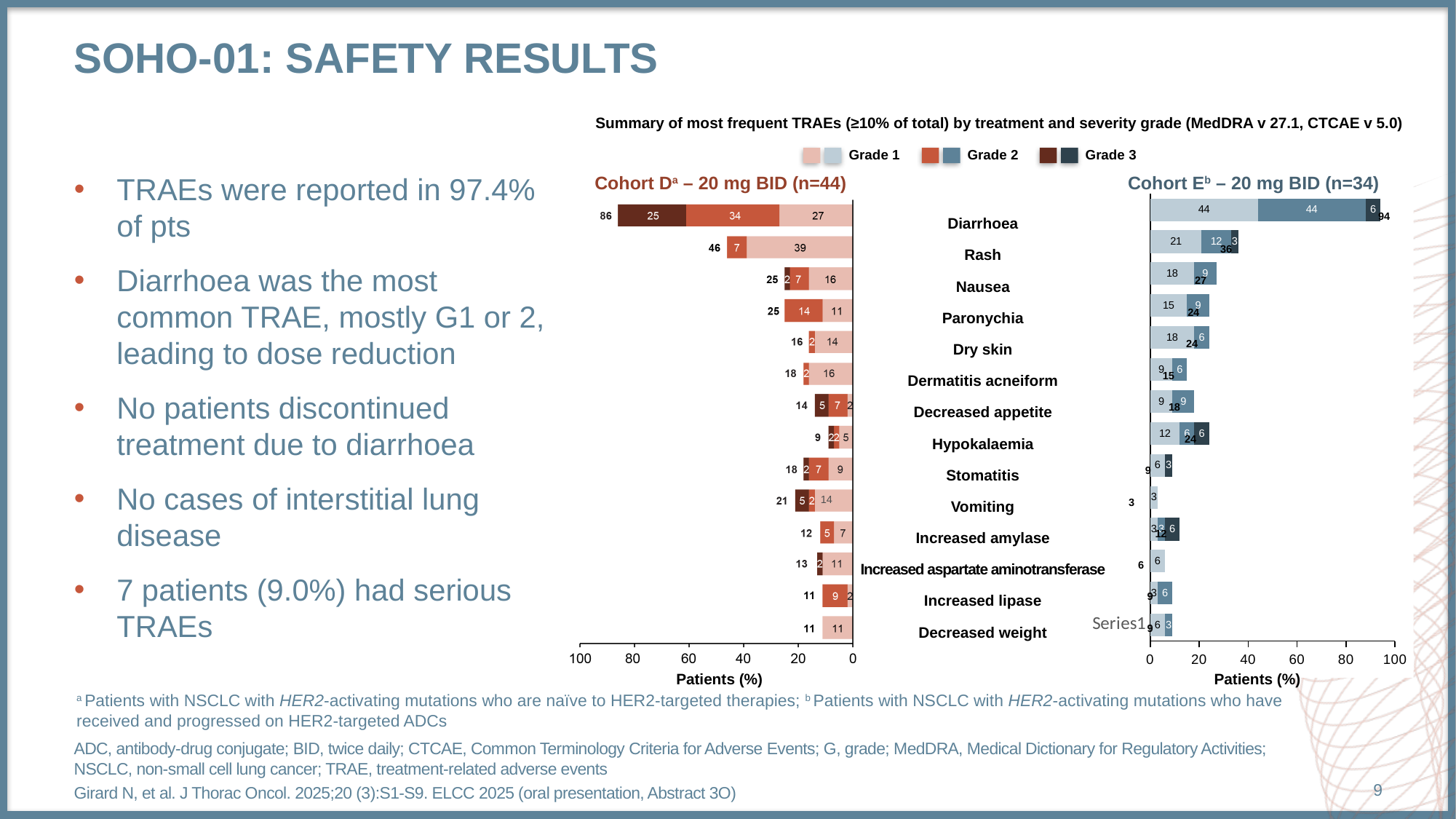
How many TRAE categories are listed on the charts? 14 How many severity grades does the legend list? 3 In the Cohort D chart, what is the sum of the Grade 1, Grade 2 and Grade 3 segments for nausea? 25 In the Cohort D chart, what is the Grade 2 value for diarrhoea? 34 In the Cohort E chart, which TRAE has the lowest total percentage of patients? Vomiting In the Cohort E chart, what is the Grade 1 value for rash? 21 In the Cohort D chart, what is the total percentage of patients with diarrhoea? 86 Which cohort has the higher total percentage for rash, Cohort D or Cohort E? Cohort D In the Cohort E chart, what is the total percentage of patients with diarrhoea? 94 What type of chart is used to show the TRAEs for each cohort? Stacked horizontal bar chart What is the difference between the total diarrhoea percentage in Cohort E and in Cohort D? 8 In the Cohort D chart, which TRAE has the highest total percentage of patients? Diarrhoea